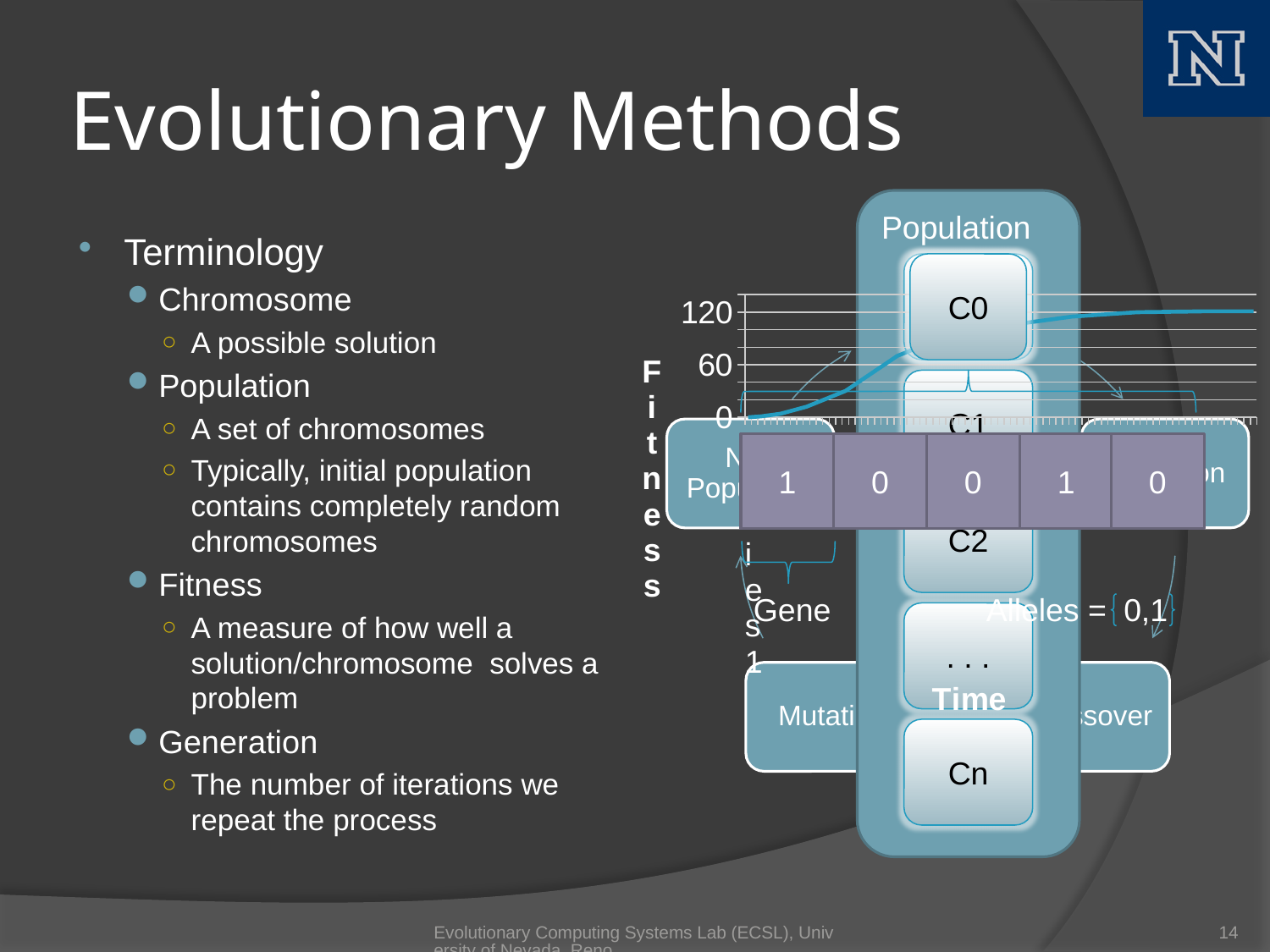
What kind of chart is shown on the right side of the slide, with the Fitness axis? line chart What is the label of the horizontal axis of the chart on the right side of the slide? Time In the Fitness versus Time chart, does the plotted line rise or fall as time increases along the x axis? rise What is the label of the vertical axis of the chart on the right side of the slide? Fitness